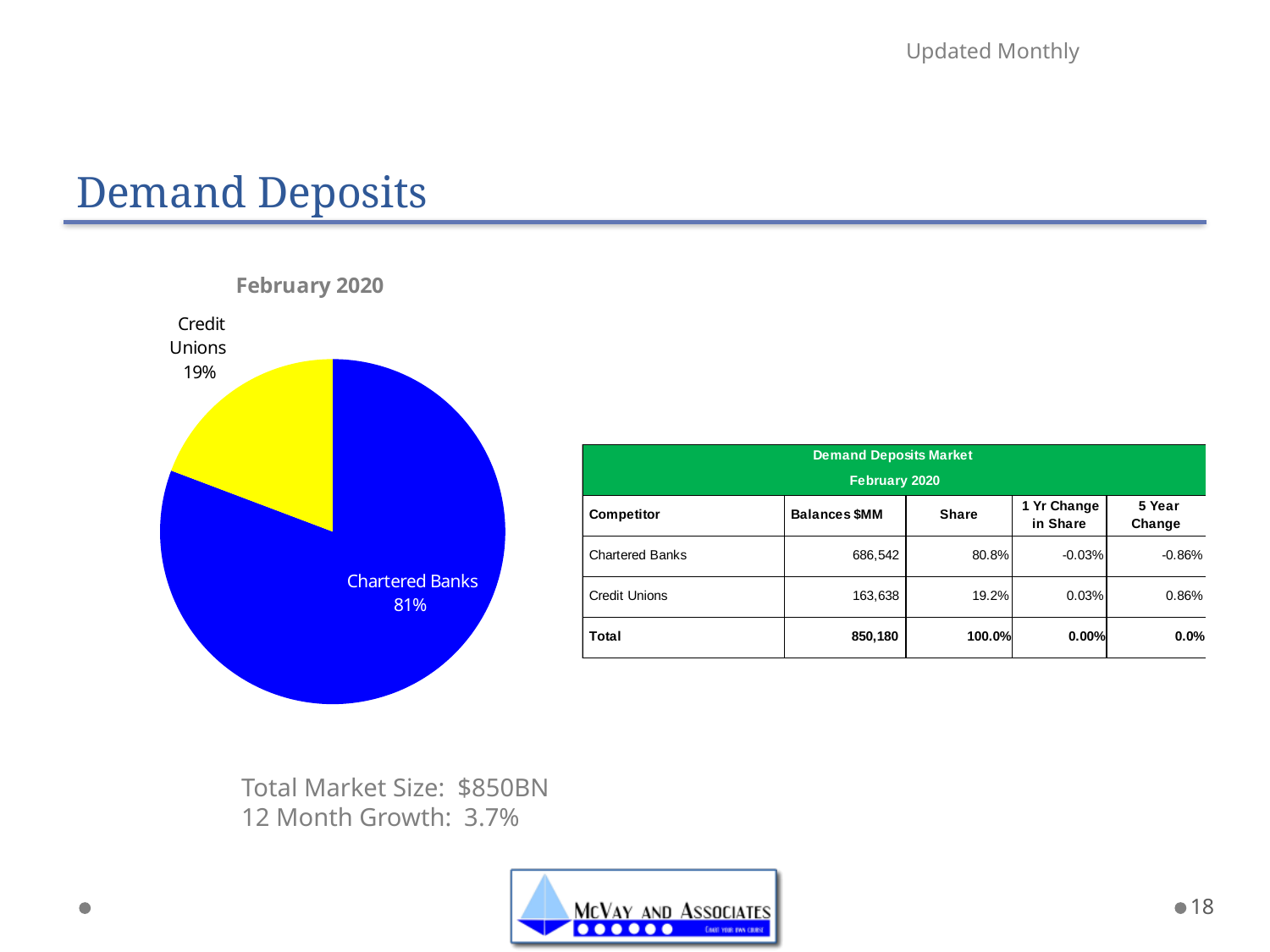
What is the difference in percentage points between the Chartered Banks slice and the Credit Unions slice? 62 Which slice of the pie chart is the largest? Chartered Banks Which is larger in the pie chart, Chartered Banks or Credit Unions? Chartered Banks What share of the pie does Credit Unions hold? 19% What share of the pie does Chartered Banks hold? 81% Which slice of the pie chart is the smallest? Credit Unions Is the share for Credit Unions in the pie chart greater or less than 50%? less What colour is the Chartered Banks slice in the pie chart? blue What is the title of the pie chart? February 2020 How many slices does the pie chart have? 2 What kind of chart is shown on the slide? pie chart